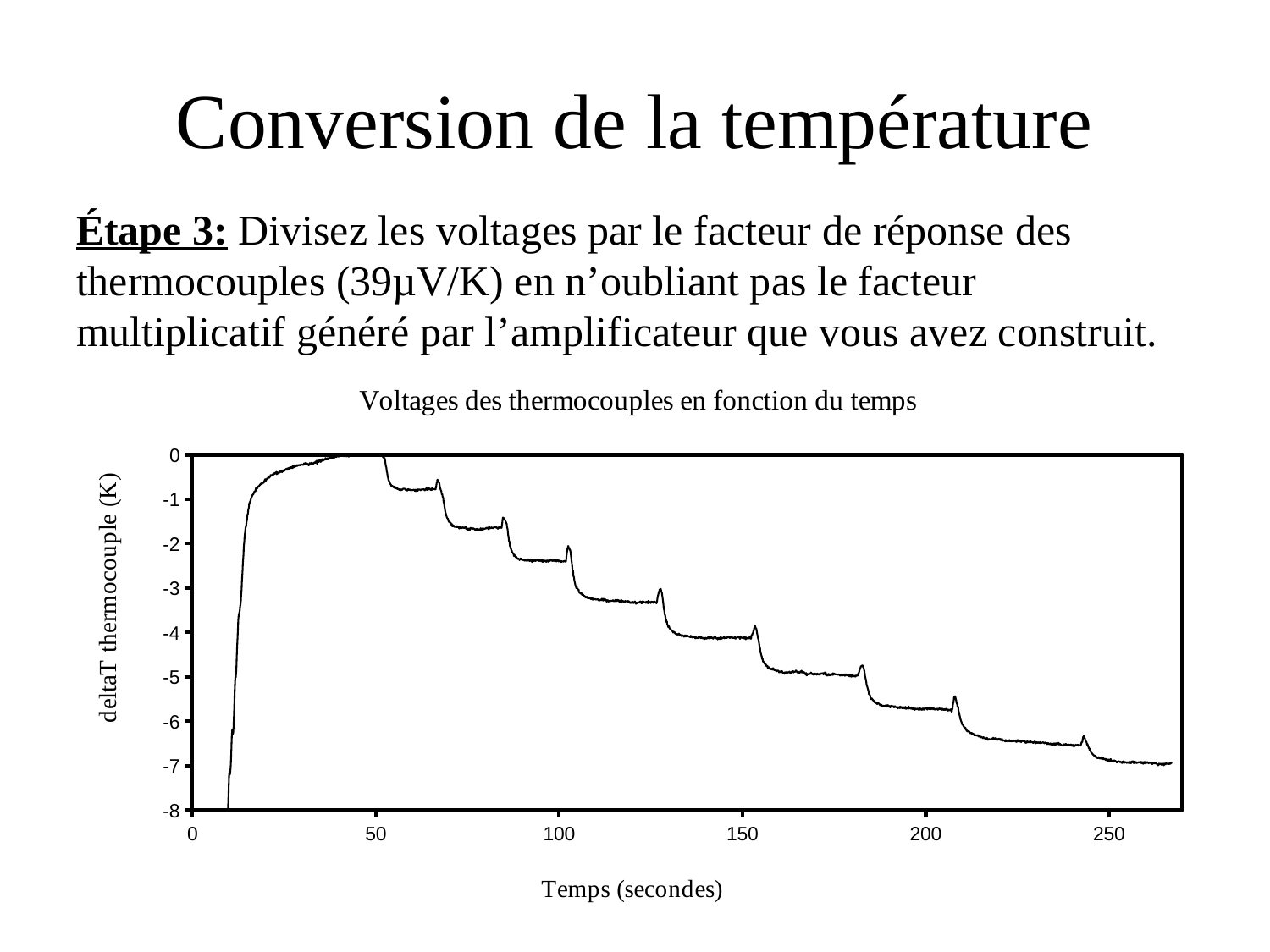
Is the value at 200 seconds greater or less than -5? less Is the value at 150 seconds greater or less than -3? less Overall, do the values rise or fall along the x axis after the initial rise at the start? fall Is the value at 100 seconds greater or less than -3? greater Which is larger, the value at 100 seconds or the value at 200 seconds? the value at 100 seconds What kind of chart is shown on the slide? line chart What is the lowest value shown on the y axis? -8 What is the title of the chart? Voltages des thermocouples en fonction du temps What is the label of the y axis of the chart? deltaT thermocouple (K)